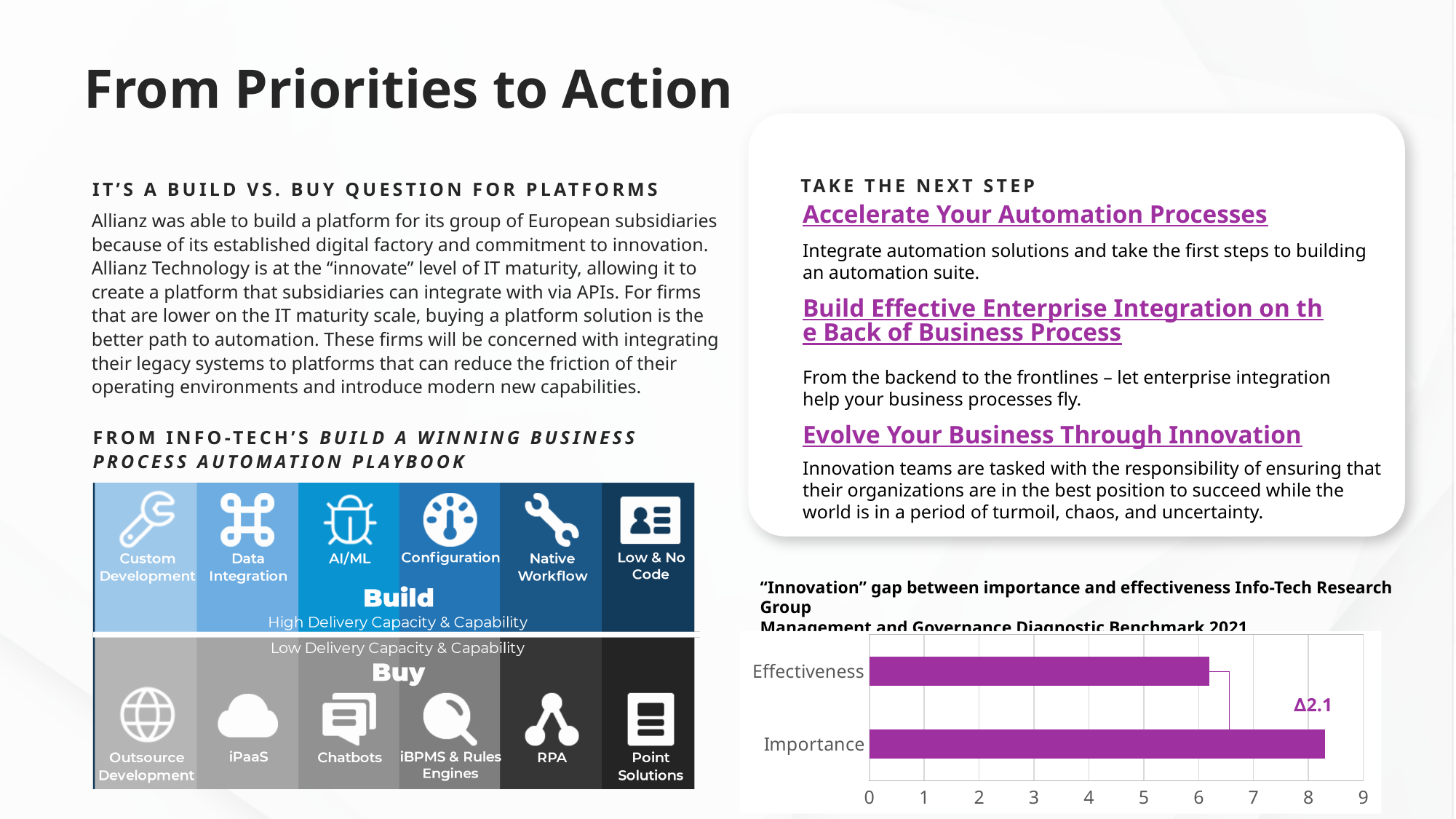
What gap between Importance and Effectiveness is labelled on the bar chart at the bottom right? Δ2.1 In the bar chart at the bottom right, is the value for Importance greater or less than 9? less In the bar chart at the bottom right, is the value for Importance larger or smaller than the value for Effectiveness? larger What kind of chart is shown at the bottom right of the slide? bar chart In the bar chart at the bottom right, which category has the lower value? Effectiveness In the bar chart at the bottom right, is the value for Importance greater or less than 8? greater In the bar chart at the bottom right, is the value for Effectiveness greater or less than 7? less What is the highest tick value on the x axis of the bar chart at the bottom right? 9 In the bar chart at the bottom right, which category has the higher value? Importance What colour are the bars in the bar chart at the bottom right? purple How many categories does the bar chart at the bottom right show? 2